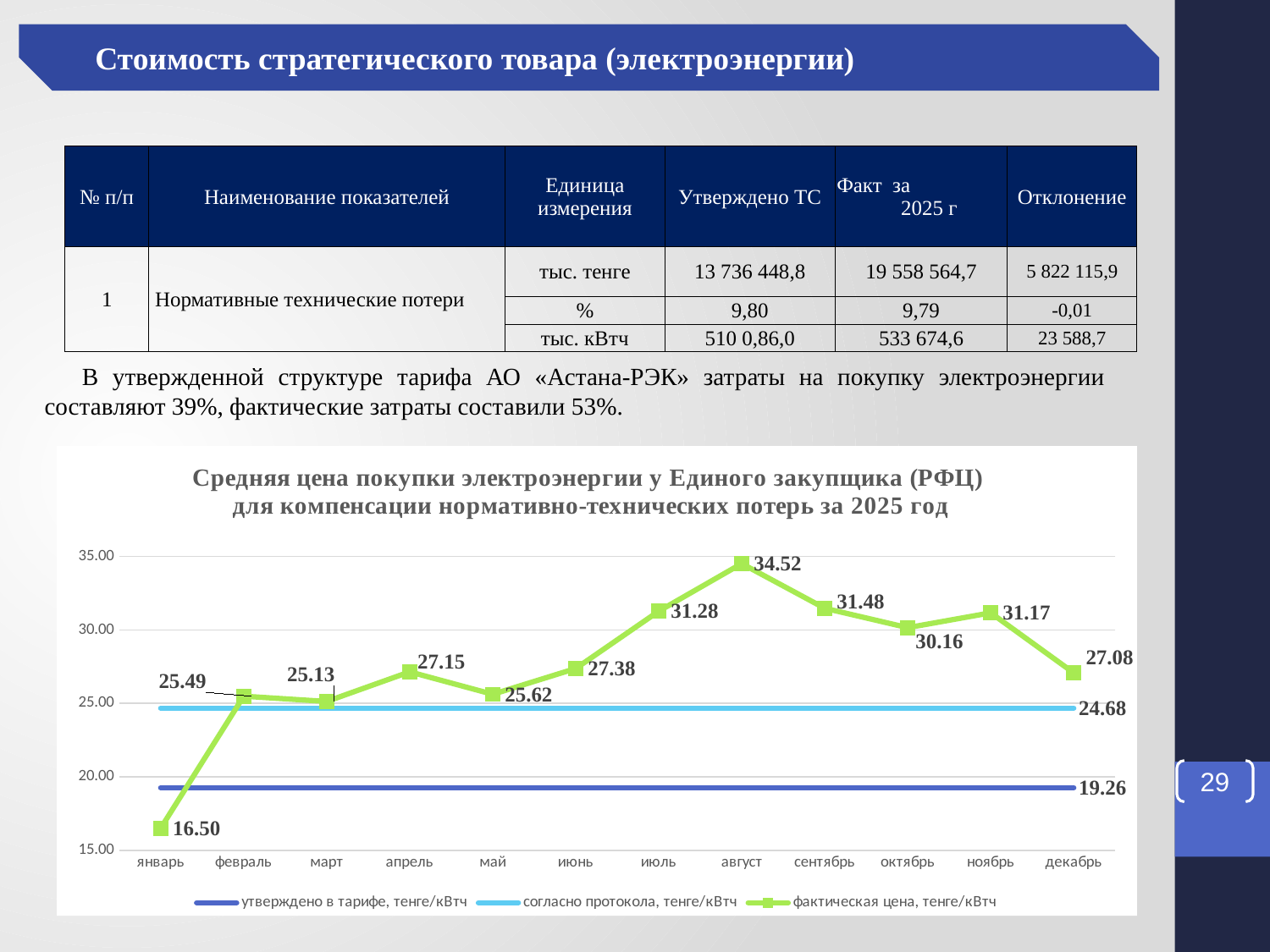
What is the actual price (фактическая цена) for декабрь? 27.08 What is the actual price (фактическая цена) for январь? 16.50 How many series does the chart legend list? 3 In which month is the actual price (фактическая цена) lowest? январь In which month is the actual price (фактическая цена) highest? август What kind of chart is shown on the slide? line chart How many months are shown on the x axis of the chart? 12 What is the difference between the actual price in август and the actual price in январь? 18.02 What is the actual price (фактическая цена) for август? 34.52 What is the value of the series 'утверждено в тарифе, тенге/кВтч'? 19.26 What is the value of the series 'согласно протокола, тенге/кВтч'? 24.68 Which is larger: the actual price in июль or the actual price in октябрь? июль